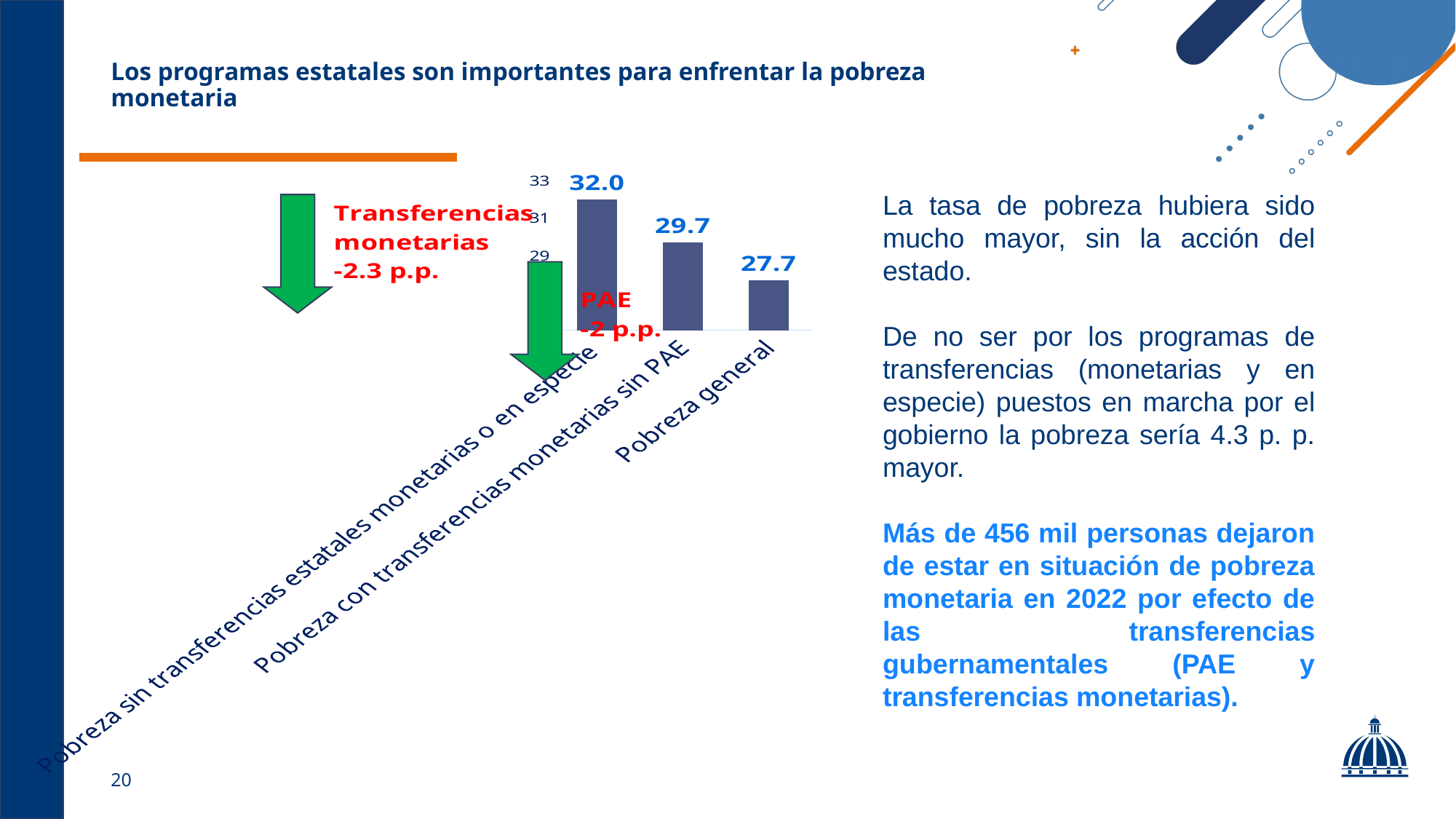
What is the difference between 'Pobreza sin transferencias estatales monetarias o en especie' and 'Pobreza general'? 4.3 Do the values rise or fall from left to right across the categories? fall Which category has the lowest value? Pobreza general Which category has the highest value? Pobreza sin transferencias estatales monetarias o en especie How many bars are shown in the chart? 3 What is the value for 'Pobreza con transferencias monetarias sin PAE'? 29.7 What is the difference between 'Pobreza con transferencias monetarias sin PAE' and 'Pobreza general'? 2.0 Is the value for 'Pobreza general' greater or less than 29? less What kind of chart is shown on the slide? bar chart Which is larger, 'Pobreza con transferencias monetarias sin PAE' or 'Pobreza general'? Pobreza con transferencias monetarias sin PAE What is the value for 'Pobreza general'? 27.7 What is the value for 'Pobreza sin transferencias estatales monetarias o en especie'? 32.0